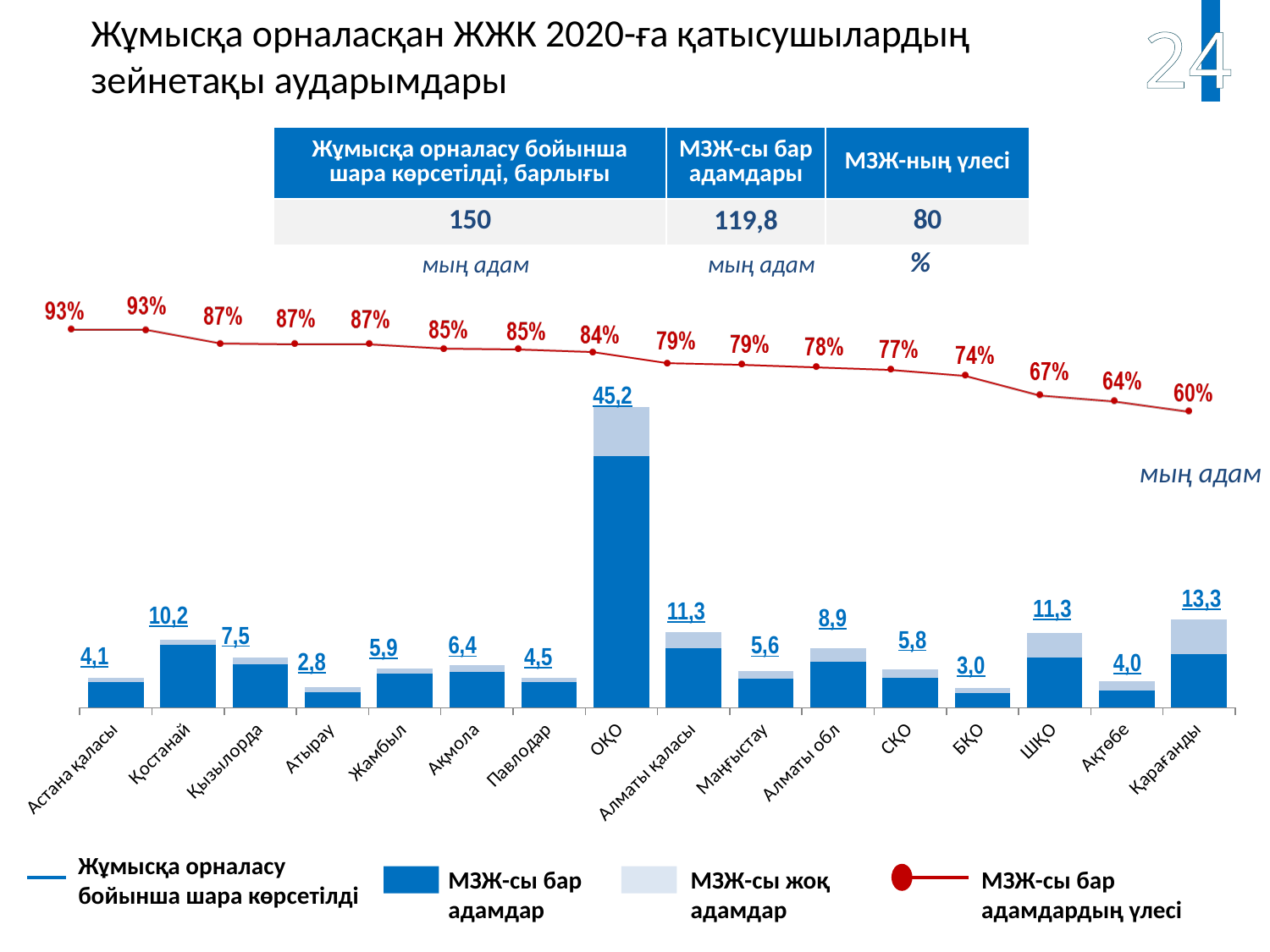
What is the total value labelled above the bar for Қарағанды? 13,3 What is the total value labelled above the bar for ОҚО? 45,2 Which region has the lowest bar total? Атырау Which region has the highest bar total? ОҚО Does the percentage line rise or fall from left to right across the chart? falls How many entries does the chart legend list? 4 Which has the larger bar total, Қостанай or Қызылорда? Қостанай Which region has the lowest percentage on the line? Қарағанды What percentage does the line show for Астана қаласы? 93% How many regions are shown on the x axis of the chart? 16 What percentage does the line show for Қарағанды? 60% What is the difference between the bar totals for ОҚО and Қарағанды? 31,9